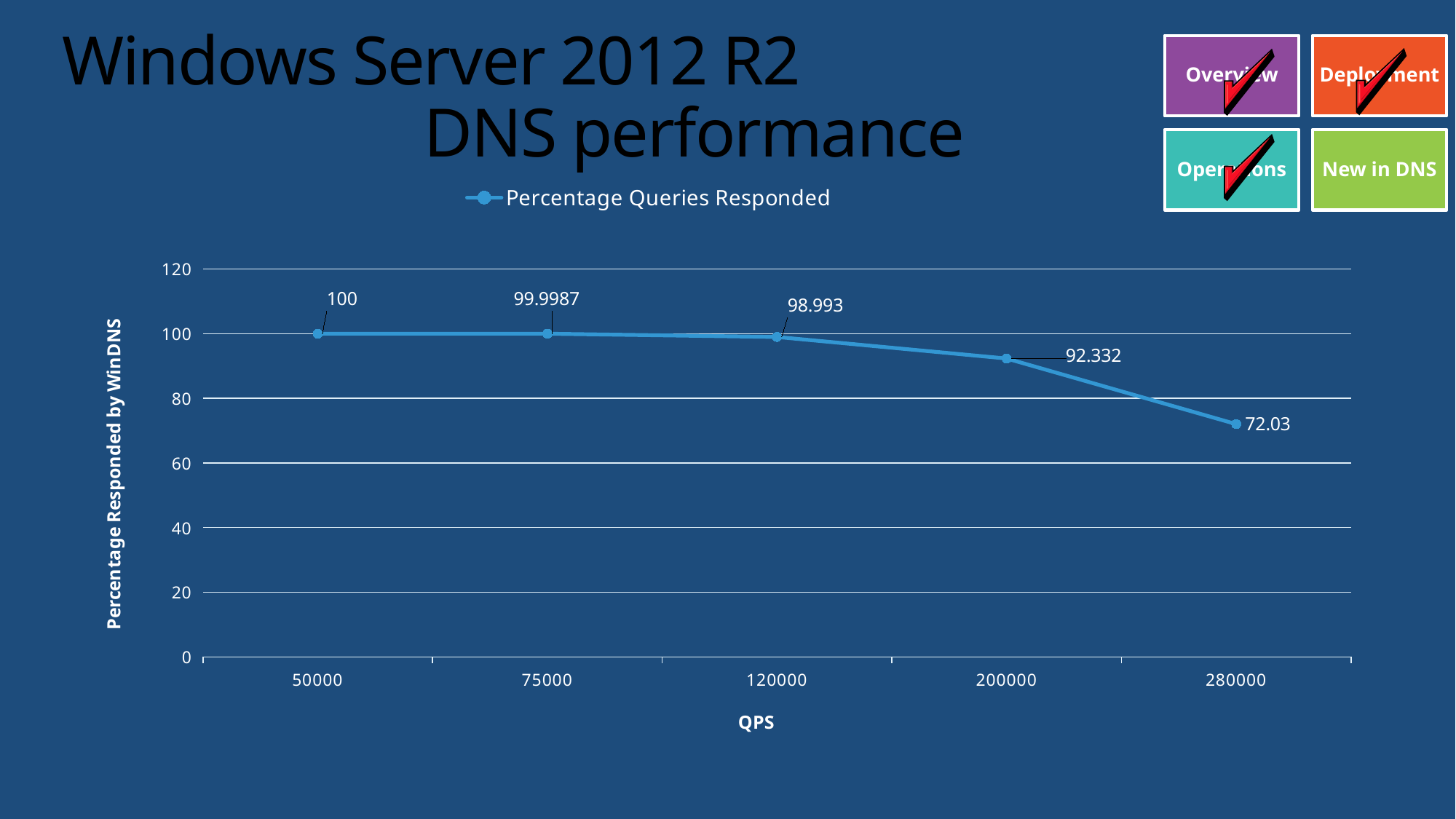
What is the difference between the Percentage Queries Responded at 200000 QPS and at 280000 QPS? 20.302 How many QPS data points are plotted on the chart? 5 What is the Percentage Queries Responded at 50000 QPS? 100 What kind of chart is shown on the slide? line chart At which QPS value is the Percentage Queries Responded highest? 50000 What is the Percentage Queries Responded at 120000 QPS? 98.993 At which QPS value is the Percentage Queries Responded lowest? 280000 What is the Percentage Queries Responded at 75000 QPS? 99.9987 Does the Percentage Queries Responded rise or fall as QPS increases? fall Which has a higher Percentage Queries Responded: 120000 QPS or 200000 QPS? 120000 What is the Percentage Queries Responded at 200000 QPS? 92.332 What is the Percentage Queries Responded at 280000 QPS? 72.03